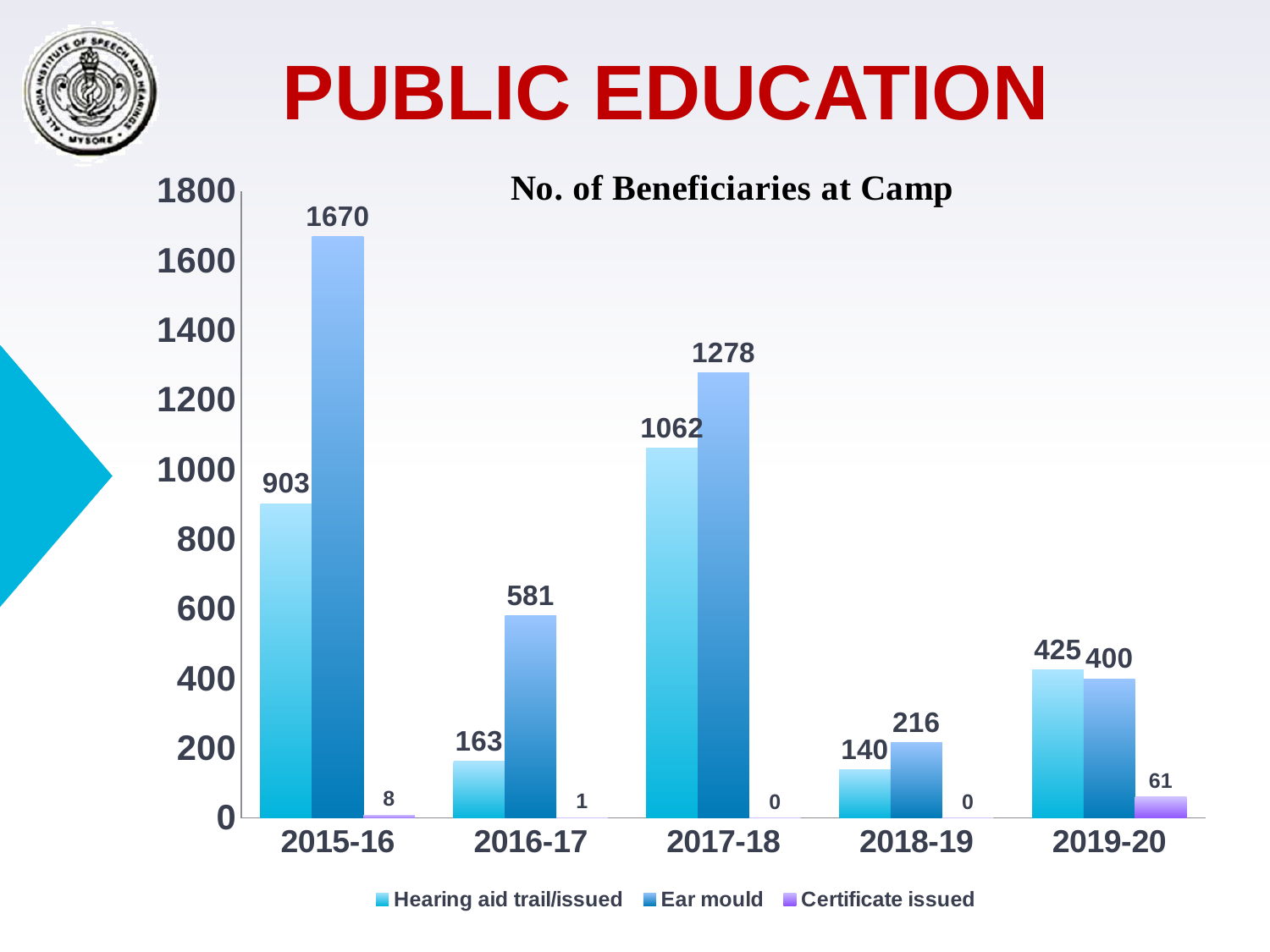
What kind of chart is shown? bar chart How many years are shown on the x axis? 5 What is the difference between Ear mould and Hearing aid trail/issued in 2016-17? 418 Which year has the lowest value for Hearing aid trail/issued? 2018-19 Is the value for Ear mould in 2017-18 greater or less than 1200? greater How many series does the legend list? 3 What is the value for Hearing aid trail/issued in 2017-18? 1062 In 2019-20, which is larger: Hearing aid trail/issued or Ear mould? Hearing aid trail/issued What is the value for Ear mould in 2015-16? 1670 What is the value for Certificate issued in 2019-20? 61 What is the title of the chart? No. of Beneficiaries at Camp Which year has the highest value for Ear mould? 2015-16